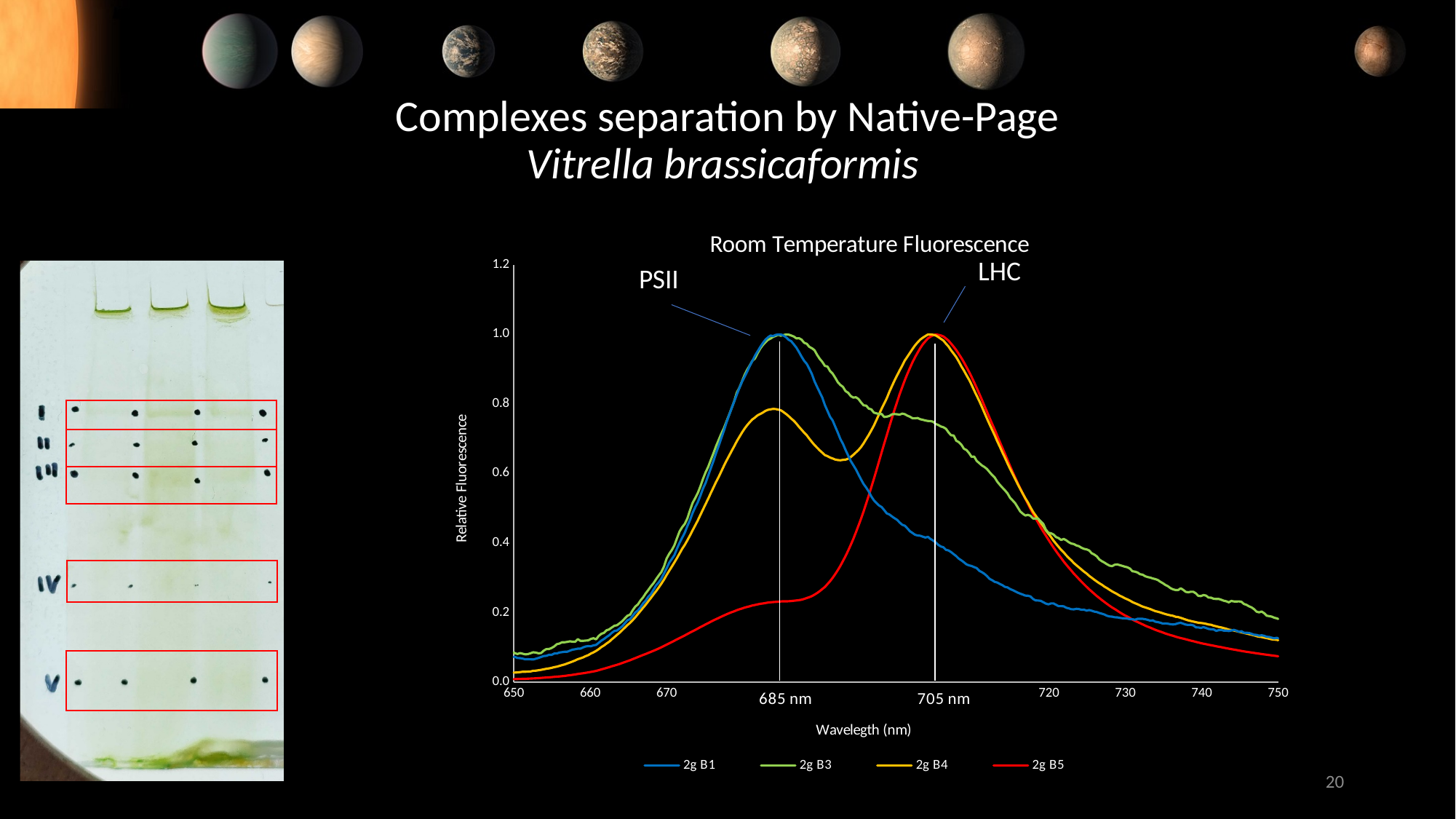
What kind of chart is the Room Temperature Fluorescence chart? line chart In the Room Temperature Fluorescence chart, which series has the lowest value at 740 nm? 2g B5 In the Room Temperature Fluorescence chart, which series has the higher value at 685 nm, 2g B1 or 2g B5? 2g B1 How many series does the legend of the Room Temperature Fluorescence chart list? 4 In the Room Temperature Fluorescence chart, is the value for 2g B5 at 685 nm greater or less than 0.4? less At which wavelength is the LHC peak marked on the Room Temperature Fluorescence chart? 705 nm In the Room Temperature Fluorescence chart, which series has the higher value at 705 nm, 2g B5 or 2g B1? 2g B5 What is the y-axis label of the Room Temperature Fluorescence chart? Relative Fluorescence At which wavelength is the PSII peak marked on the Room Temperature Fluorescence chart? 685 nm What is the title of the chart on the slide? Room Temperature Fluorescence In the Room Temperature Fluorescence chart, is the value for 2g B4 at 685 nm greater or less than 0.6? greater In the Room Temperature Fluorescence chart, is the value for 2g B1 at 705 nm greater or less than 0.6? less